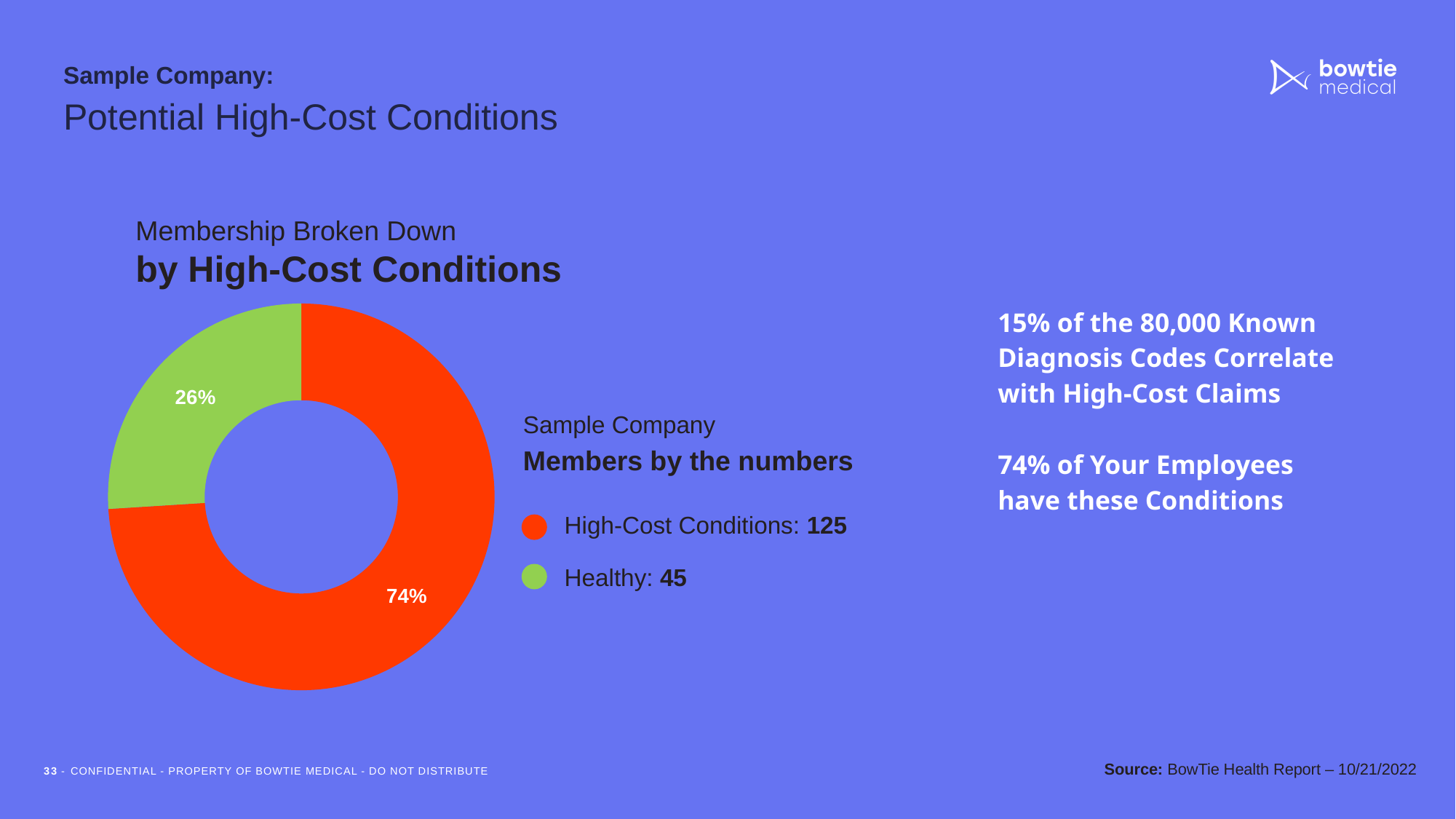
Which slice of the pie chart is the largest? High-Cost Conditions What percentage of the pie chart is labelled for High-Cost Conditions? 74% What is the difference in member count between High-Cost Conditions and Healthy? 80 How many members are listed under High-Cost Conditions in the legend? 125 Which slice of the pie chart is the smallest? Healthy How many slices does the pie chart have? 2 What colour is the Healthy slice in the pie chart? Green How many members are listed under Healthy in the legend? 45 What kind of chart is shown on the slide? Doughnut chart Which is larger, the High-Cost Conditions slice or the Healthy slice? High-Cost Conditions What is the total number of members shown in the legend? 170 What percentage of the pie chart is labelled for Healthy? 26%